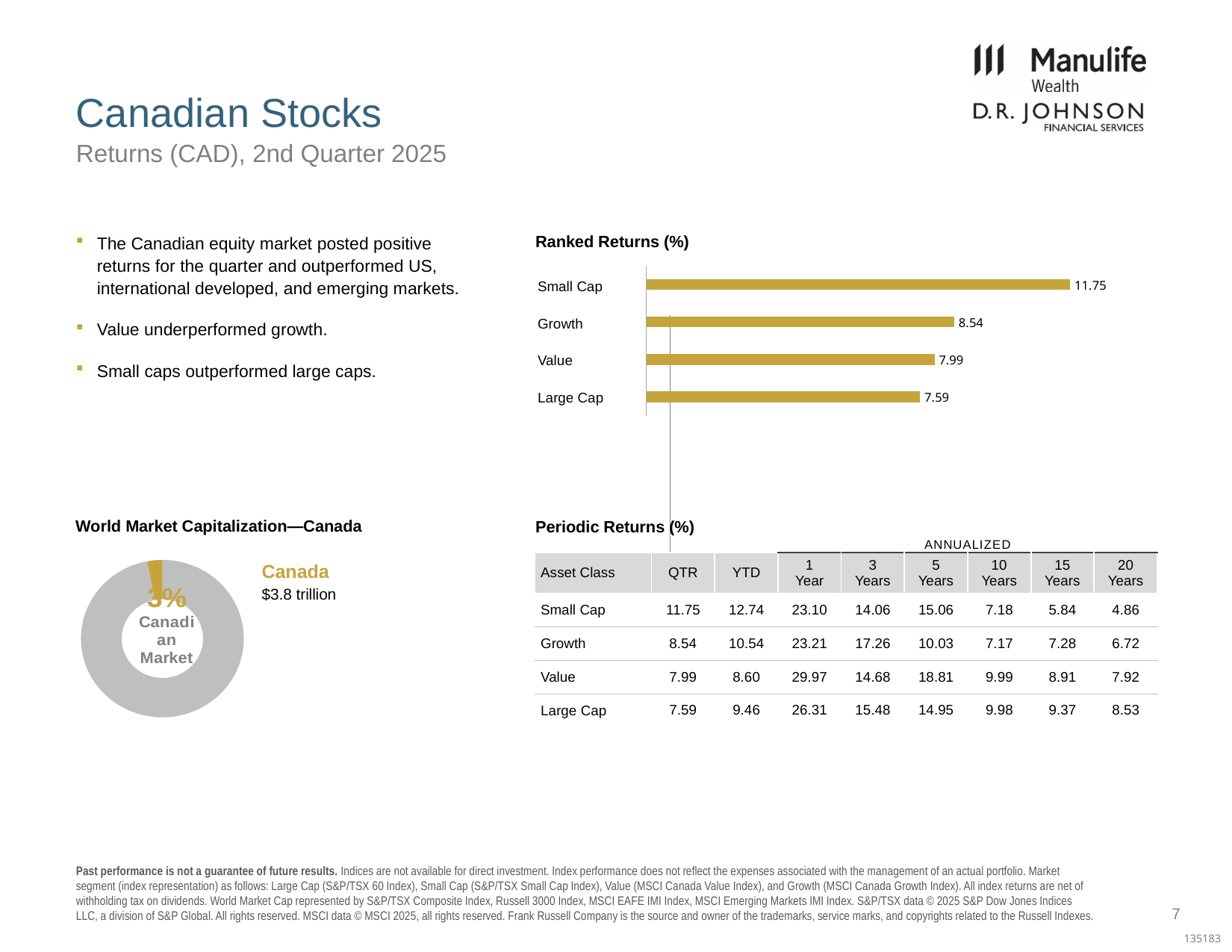
In the Ranked Returns (%) chart, which category has the lowest return? Large Cap What kind of chart is the World Market Capitalization—Canada chart? Doughnut chart In the Ranked Returns (%) chart, what is the value for Value? 7.99 In the Ranked Returns (%) chart, which category has the highest return? Small Cap How many categories are shown in the Ranked Returns (%) chart? 4 In the Ranked Returns (%) chart, what is the value for Growth? 8.54 In the Ranked Returns (%) chart, what is the difference between the Growth and Value values? 0.55 In the Ranked Returns (%) chart, which is larger, Growth or Large Cap? Growth In the Ranked Returns (%) chart, what is the value for Large Cap? 7.59 In the Ranked Returns (%) chart, what is the value for Small Cap? 11.75 What kind of chart is the Ranked Returns (%) chart? Bar chart In the Ranked Returns (%) chart, what is the difference between the Small Cap and Large Cap values? 4.16